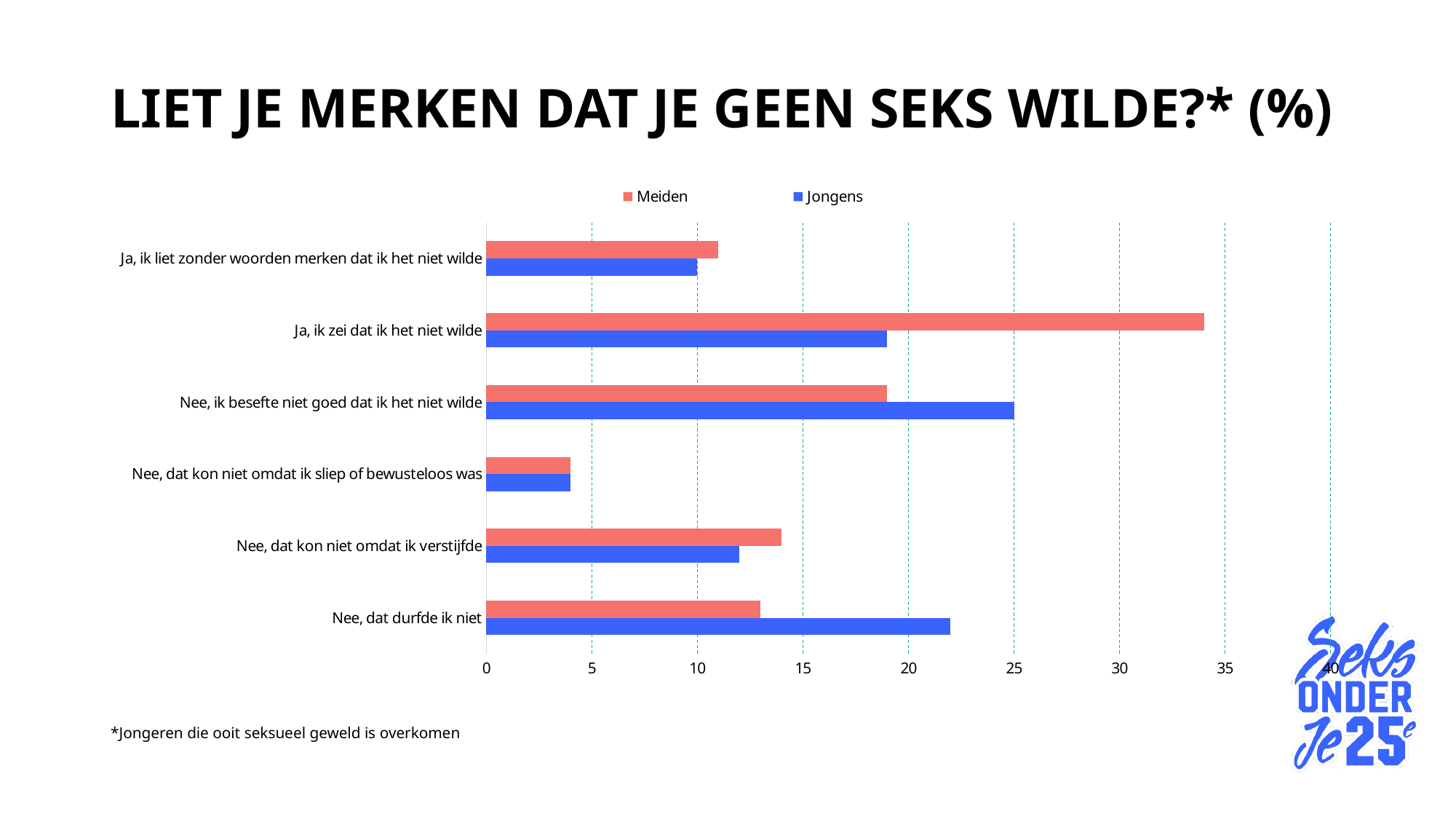
What kind of chart is shown on the slide? bar chart Is the value for Meiden in 'Ja, ik zei dat ik het niet wilde' greater or less than 30? greater Which category has the highest value for Jongens? Nee, ik besefte niet goed dat ik het niet wilde For 'Nee, dat durfde ik niet', which is larger: Meiden or Jongens? Jongens For 'Ja, ik zei dat ik het niet wilde', which is larger: Meiden or Jongens? Meiden Is the value for Jongens in 'Nee, dat durfde ik niet' greater or less than 20? greater Is the value for Meiden in 'Nee, dat kon niet omdat ik sliep of bewusteloos was' greater or less than 5? less How many categories are shown on the chart? 6 How many series does the legend list? 2 Which category has the lowest value for Meiden? Nee, dat kon niet omdat ik sliep of bewusteloos was Which category has the highest value for Meiden? Ja, ik zei dat ik het niet wilde Which series is shown in blue in the legend? Jongens